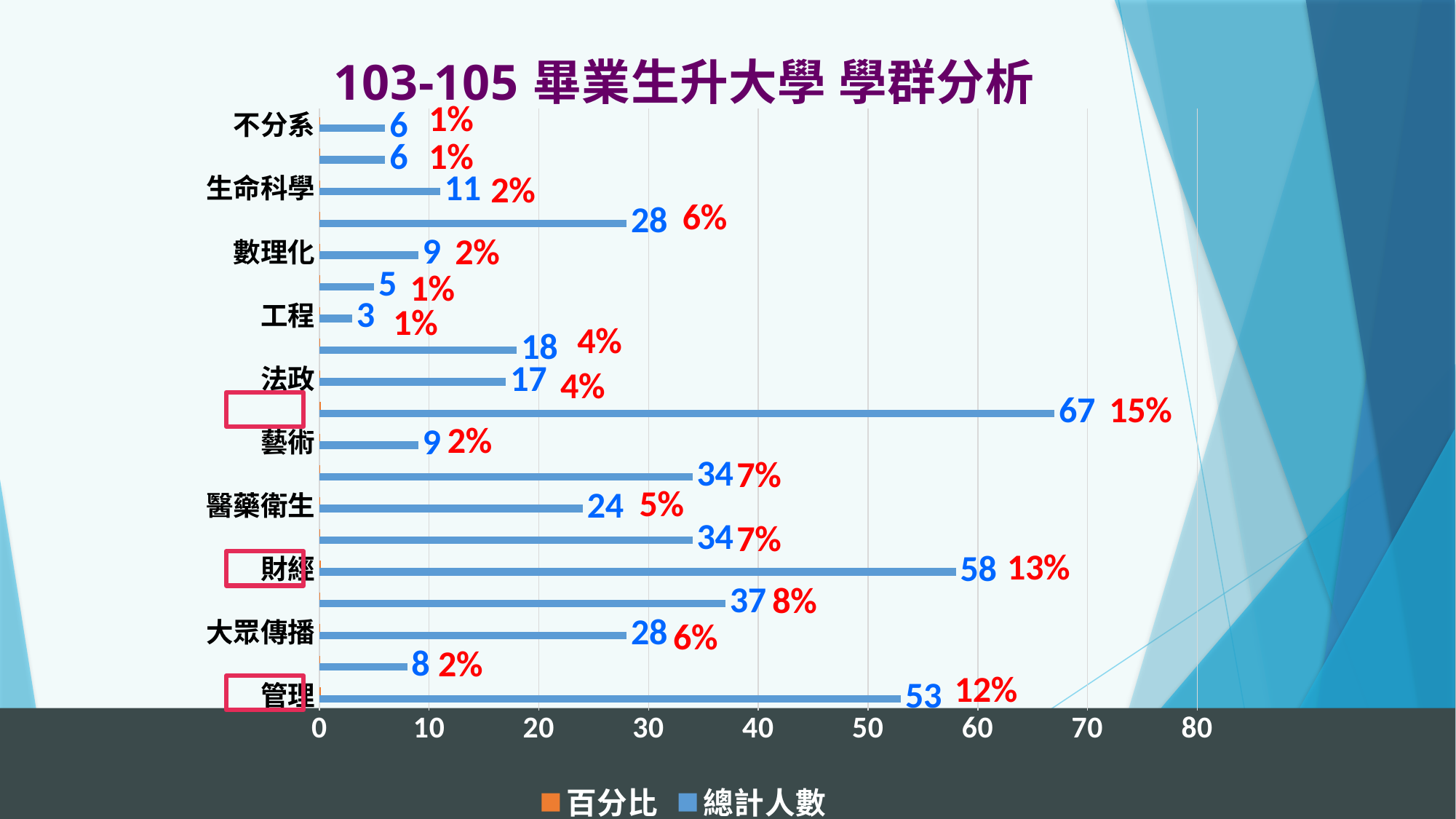
What is the highest 總計人數 value shown on the chart? 67 How many series does the legend list? 2 Which has the larger 總計人數, 財經 or 管理? 財經 What is the 總計人數 value for 醫藥衛生? 24 What is the difference in 總計人數 between 財經 and 管理? 5 What is the title of the chart? 103-105 畢業生升大學 學群分析 What type of chart is shown on the slide? bar chart What is the 總計人數 value for 工程? 3 What percentage is shown for 管理? 12% Is the 總計人數 value for 大眾傳播 greater or less than 20? greater What is the 總計人數 value for 財經? 58 What percentage is shown for 法政? 4%